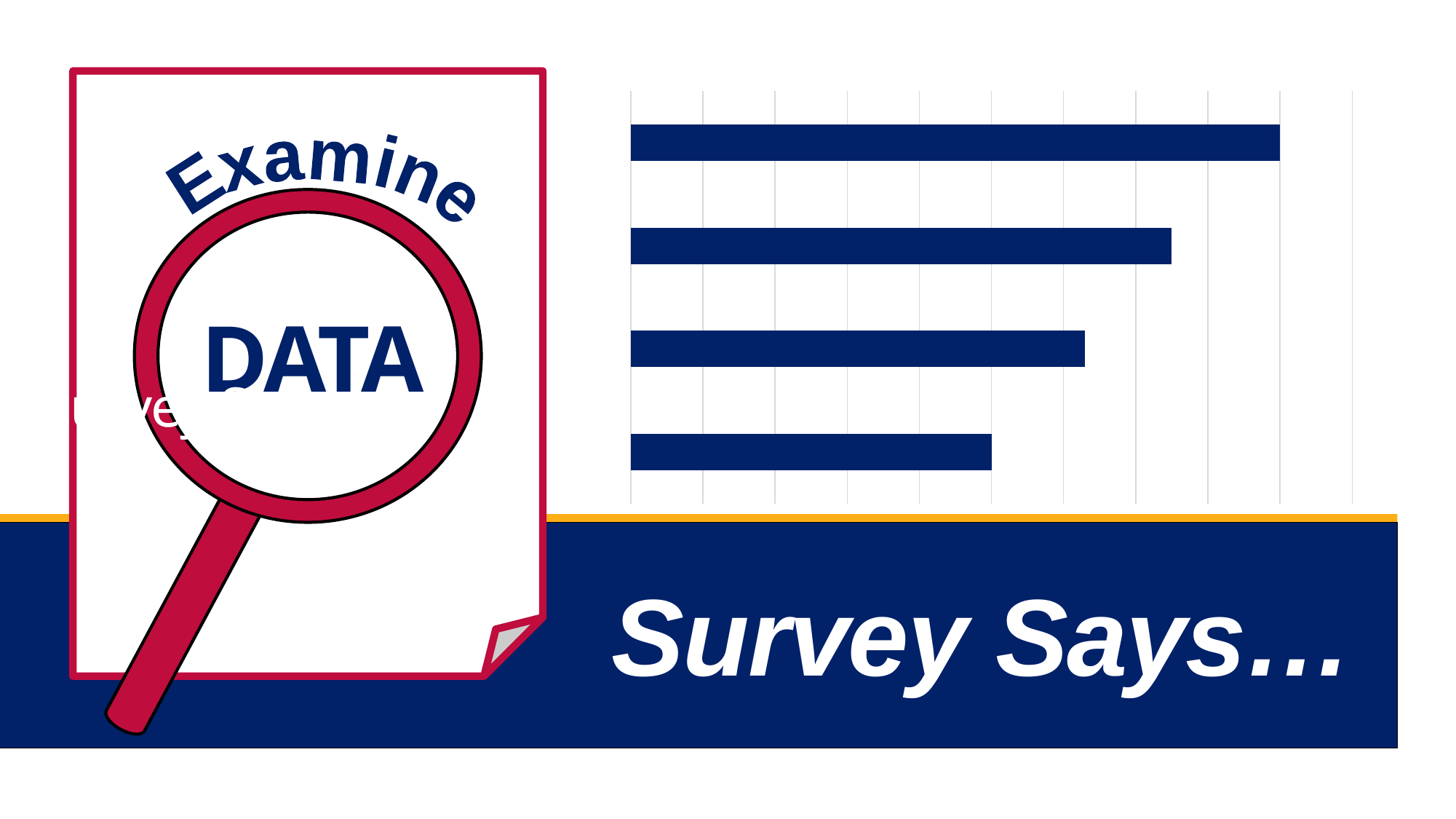
Do the bar lengths increase or decrease going from the top bar to the bottom bar? decrease Is the second bar from the top longer or shorter than the third bar from the top? longer Are the bars in the chart horizontal or vertical? horizontal Which bar in the chart is the shortest? the bottom bar How many bars does the chart on the slide have? 4 Which bar in the chart is the longest: the top one or the bottom one? the top one Does the chart display a legend? No What colour are the bars in the chart? dark blue What kind of chart is shown on the right side of the slide? bar chart